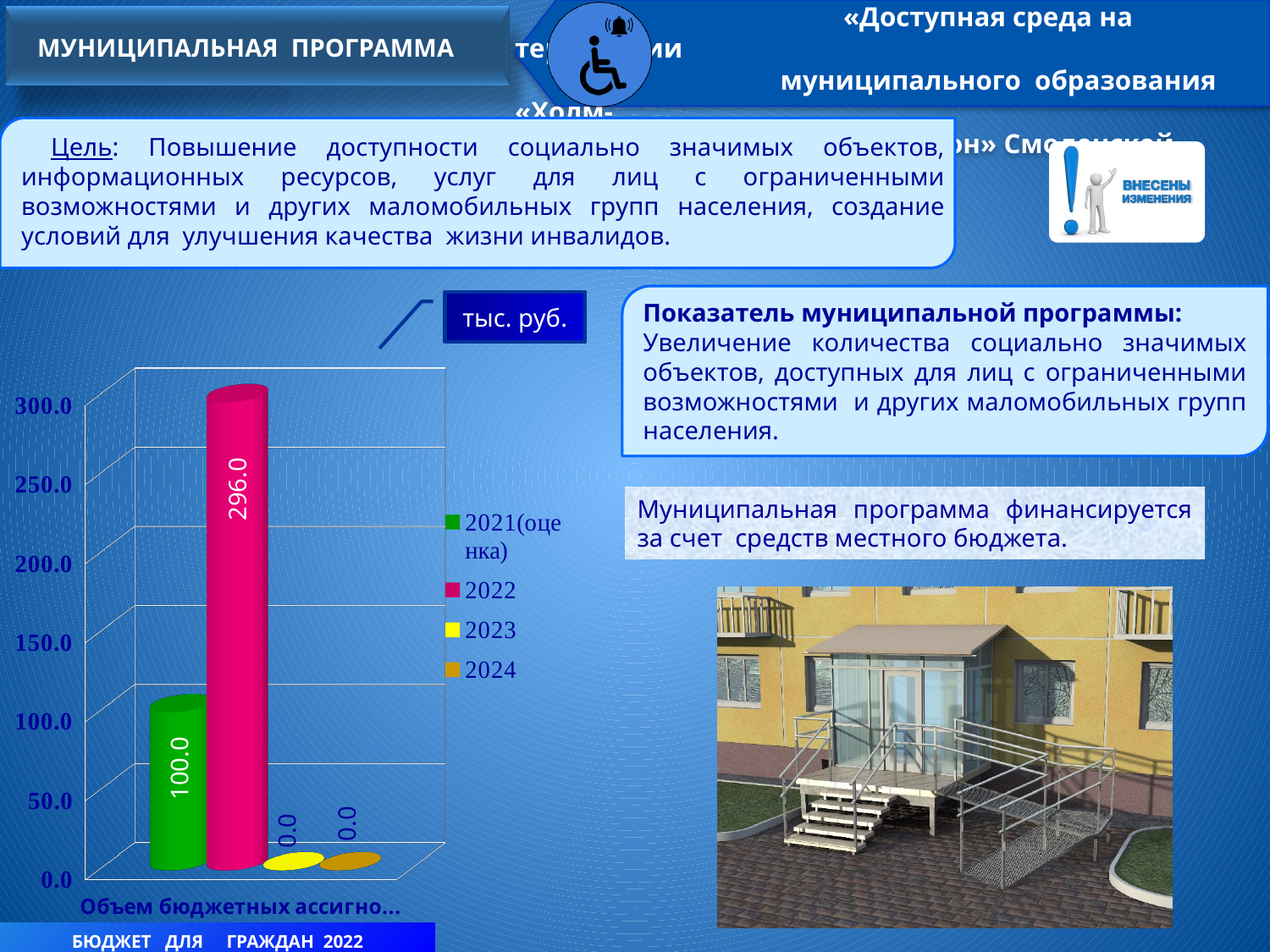
What is the difference between the values for 2022 and 2021(оценка)? 196.0 What kind of chart is shown on the slide? bar chart What unit is shown in the box above the chart? тыс. руб. Is the value for 2022 greater or less than 250.0? greater What is the value for 2023 on the chart? 0.0 Which year has the highest value on the chart? 2022 What colour is the bar for 2022? pink How many series does the legend list? 4 Which is larger, the value for 2021(оценка) or the value for 2022? 2022 What is the value for 2022 on the chart? 296.0 What is the value for 2021(оценка) on the chart? 100.0 What is the value for 2024 on the chart? 0.0